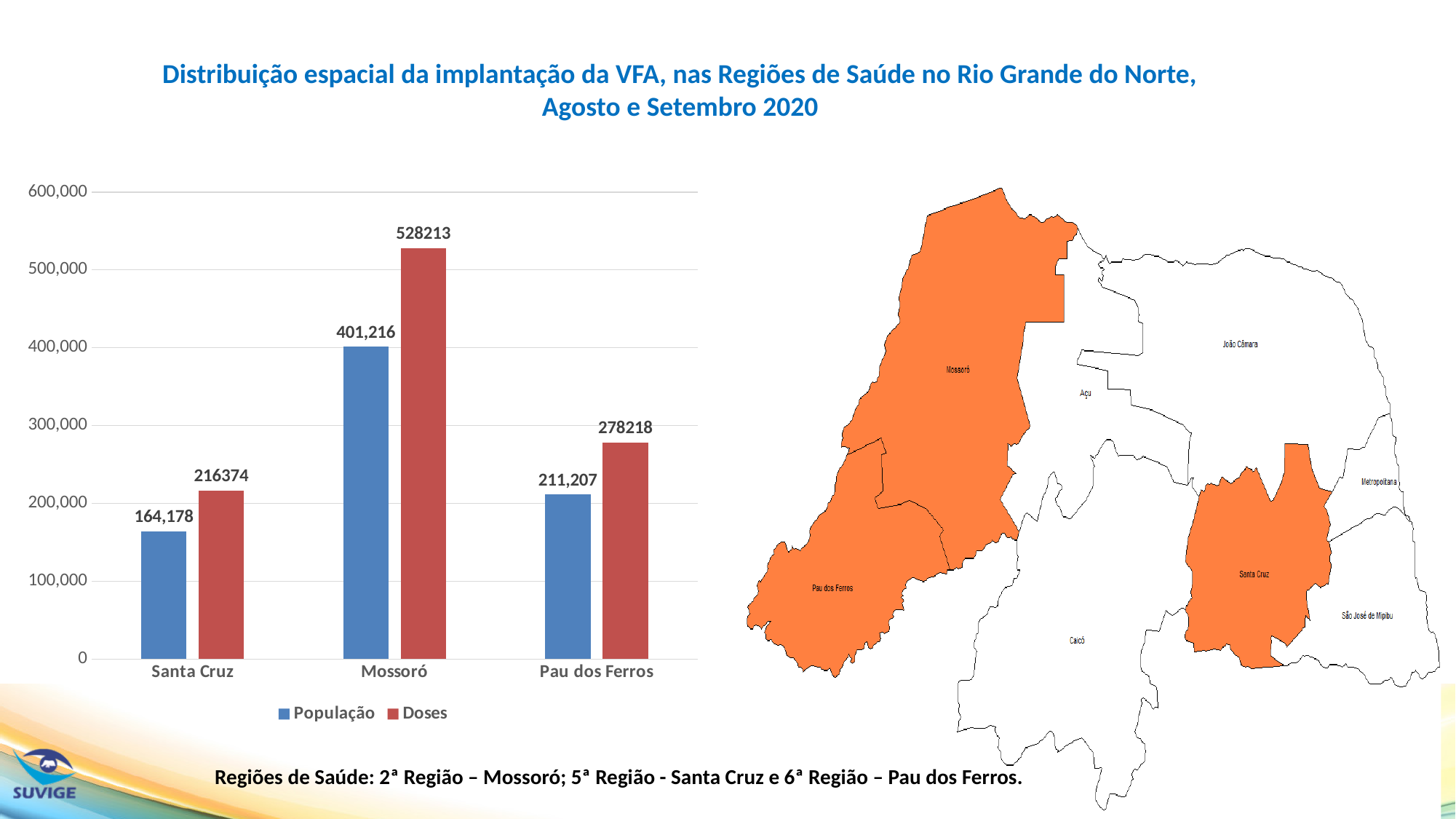
What is the Doses value for Pau dos Ferros? 278218 What is the Doses value for Santa Cruz? 216374 How many series does the legend of the bar chart list? 2 Which region has the lowest População value? Santa Cruz What is the difference between Doses and População for Mossoró? 126,997 What kind of chart is shown on the left of the slide? Bar chart Is the Doses value for Mossoró greater or less than 500,000? greater What is the População value for Mossoró? 401,216 What is the População value for Santa Cruz? 164,178 Which is larger for Pau dos Ferros, População or Doses? Doses How many regions are shown on the x axis of the bar chart? 3 Which region has the highest Doses value? Mossoró